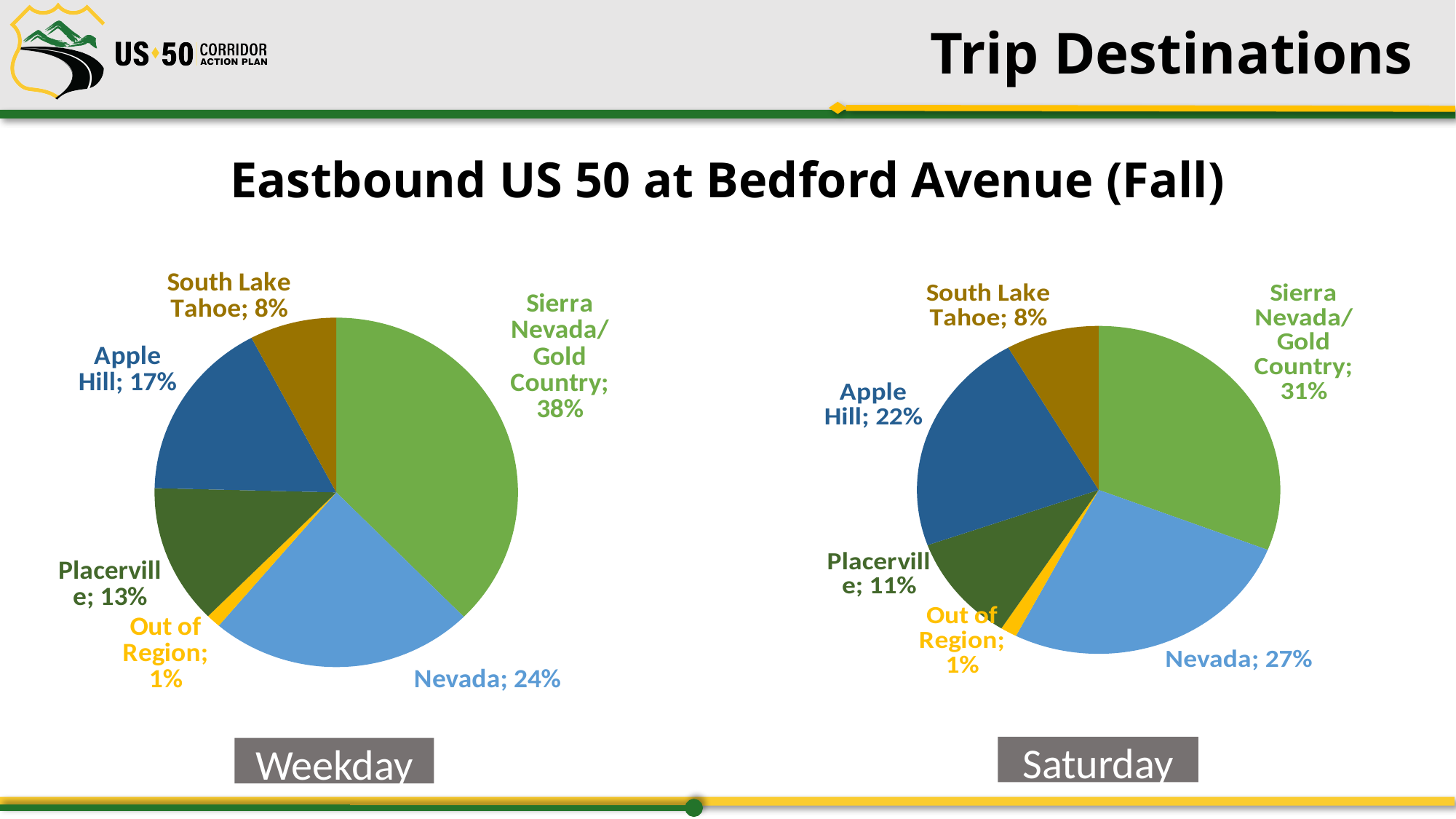
What type of chart is used for the Saturday data? Pie chart In the Saturday pie chart, what share of trips goes to Nevada? 27% How many slices does the Weekday pie chart have? 6 In the Weekday pie chart, what share of trips goes to Sierra Nevada/Gold Country? 38% What is the title shown above the two pie charts? Eastbound US 50 at Bedford Avenue (Fall) In the Saturday pie chart, what share of trips goes to Apple Hill? 22% In the Weekday pie chart, what is the difference between the Nevada share and the Placerville share? 11% In the Weekday pie chart, which destination has the largest share? Sierra Nevada/Gold Country What is the difference between the Sierra Nevada/Gold Country share in the Weekday chart and in the Saturday chart? 7% In the Saturday pie chart, which destination has the smallest share? Out of Region In the Saturday pie chart, which is larger: the share for Nevada or the share for Apple Hill? Nevada In the Weekday pie chart, what share of trips goes to South Lake Tahoe? 8%